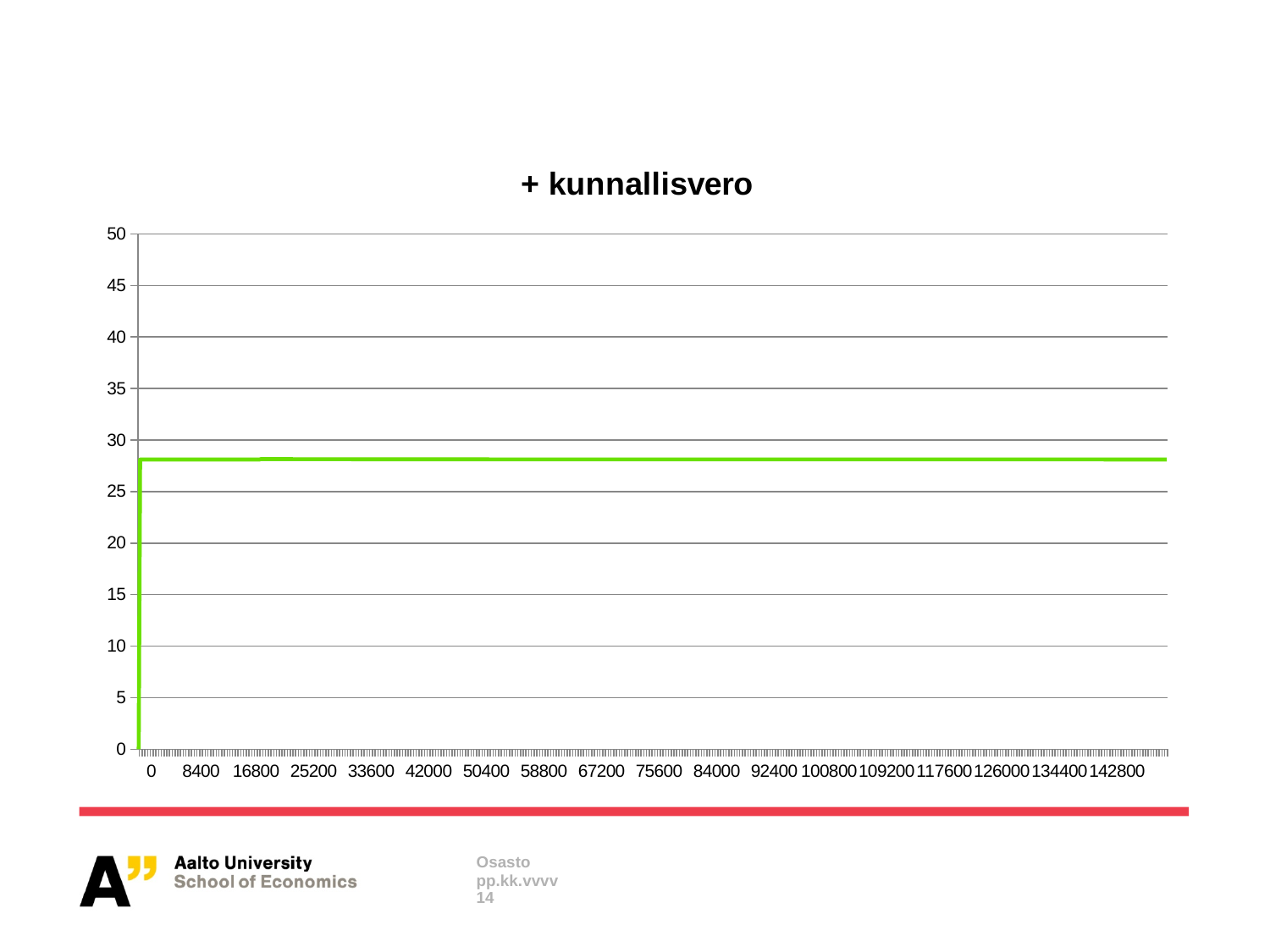
Is the value at x = 84000 greater or less than 25? greater What is the step between consecutive tick labels on the vertical axis? 5 After the initial jump near x = 0, does the line rise, fall, or stay roughly flat as x increases? stays roughly flat What is the largest label shown on the horizontal axis? 142800 What is the title of the chart? + kunnallisvero Is the value at x = 84000 greater or less than 30? less Is the value at x = 142800 greater or less than 20? greater What kind of chart is shown on the slide? line chart